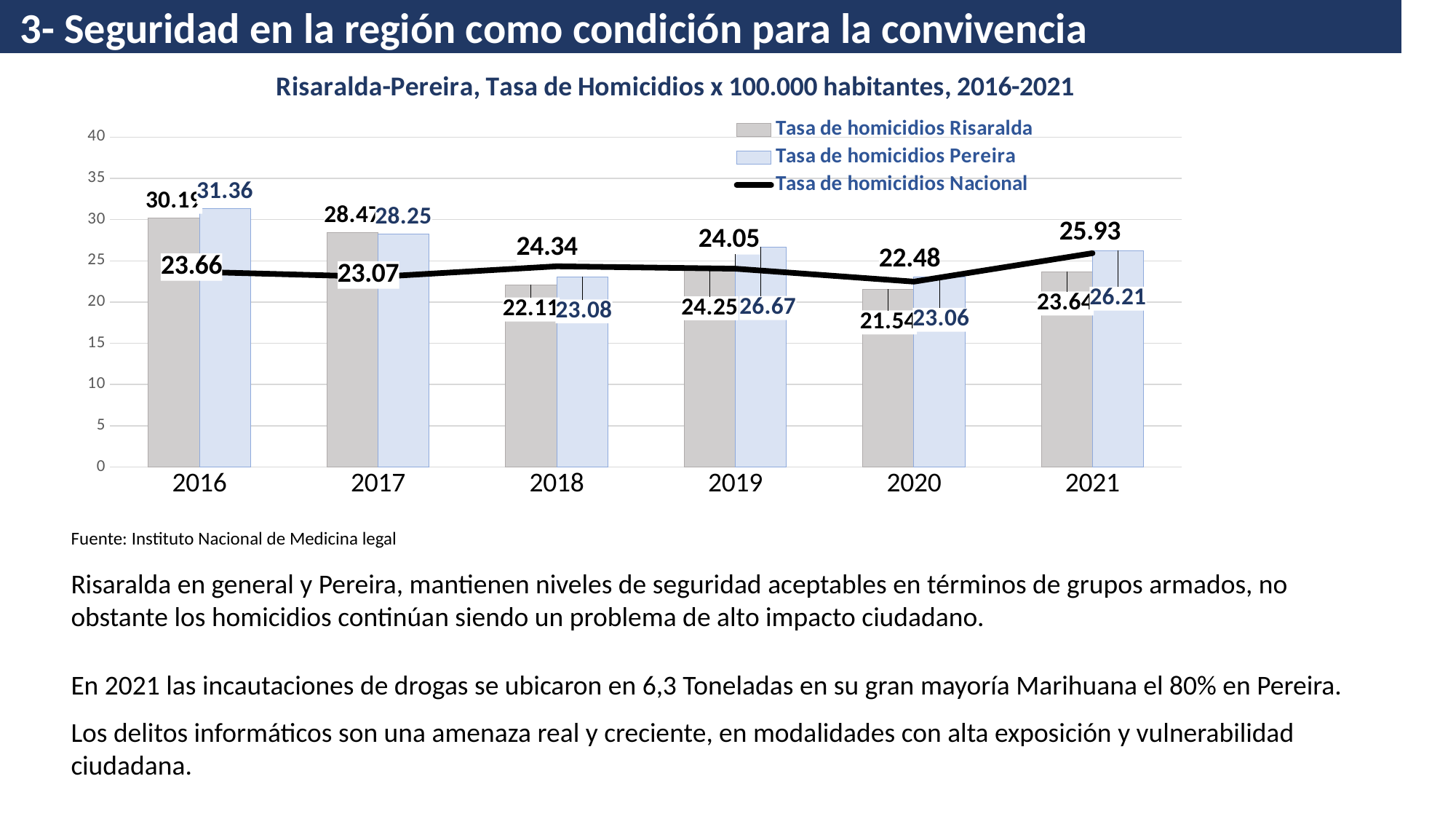
In which year is the Tasa de homicidios Nacional lowest? 2020 In which year is the Tasa de homicidios Pereira highest? 2016 Does the Tasa de homicidios Pereira rise or fall from 2016 to 2018? fall What is the Tasa de homicidios Risaralda value for 2018? 22.11 What is the difference between the Pereira and Risaralda homicide rates in 2019? 2.42 Is the Tasa de homicidios Risaralda value for 2016 greater or less than 25? greater How many series does the chart legend list? 3 What is the Tasa de homicidios Pereira value for 2019? 26.67 In 2018, which is larger: the Tasa de homicidios Pereira or the Tasa de homicidios Nacional? Tasa de homicidios Nacional What is the Tasa de homicidios Pereira value for 2016? 31.36 What is the Tasa de homicidios Nacional value for 2018? 24.34 How many years are shown on the x axis of the chart? 6